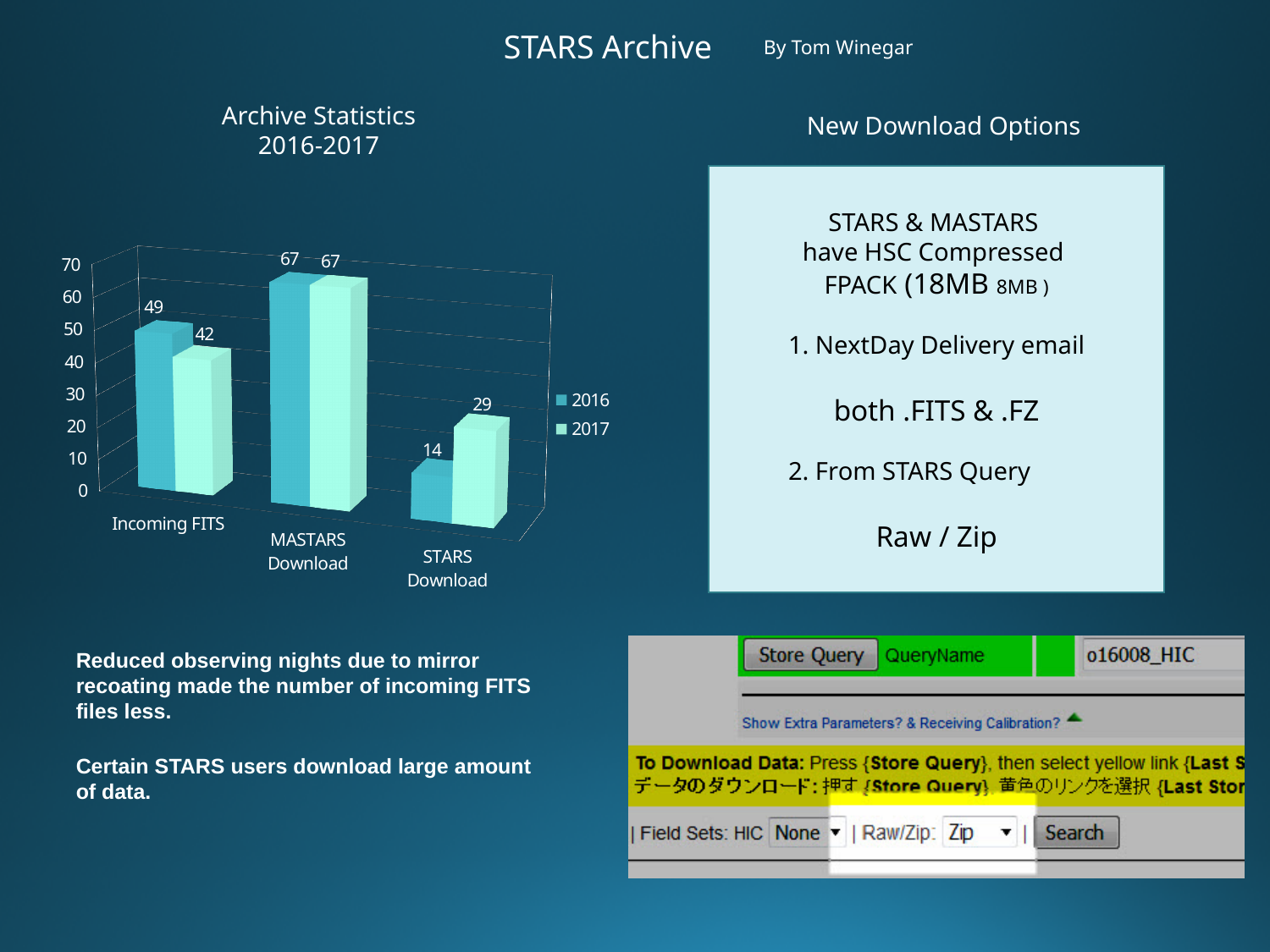
What is the value for Incoming FITS in 2016? 49 Which category has the lowest value for 2016? STARS Download Which is larger for STARS Download, the 2016 value or the 2017 value? 2017 What is the difference between the 2017 and 2016 values for STARS Download? 15 What is the title of the chart? Archive Statistics 2016-2017 What is the value for MASTARS Download in 2016? 67 Which category has the highest value for 2017? MASTARS Download What kind of chart is shown on the slide? bar chart How many categories are shown on the x axis of the chart? 3 What is the difference between the 2016 and 2017 values for Incoming FITS? 7 How many series does the chart legend list? 2 What is the value for STARS Download in 2017? 29